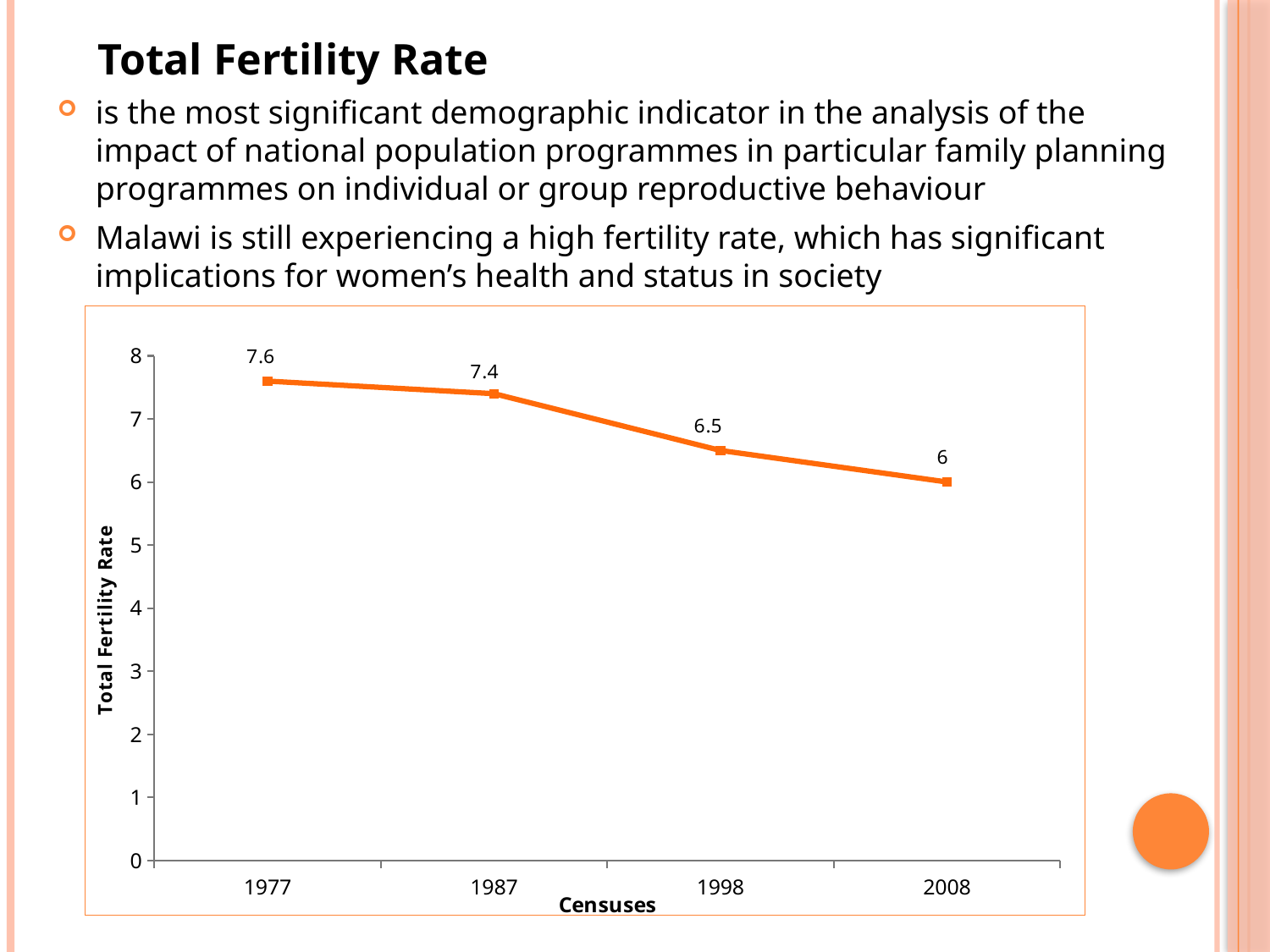
Does the total fertility rate rise or fall across the census years from 1977 to 2008? Fall Which census year has the lowest total fertility rate? 2008 What kind of chart is shown on the slide? Line chart What is the difference between the total fertility rate in 1987 and in 1998? 0.9 What is the total fertility rate for the 2008 census? 6 What is the total fertility rate for the 1987 census? 7.4 What is the total fertility rate for the 1998 census? 6.5 How many census years are plotted on the chart? 4 What is the difference between the total fertility rate in 1977 and in 2008? 1.6 What is the total fertility rate for the 1977 census? 7.6 Which is larger, the total fertility rate in 1987 or in 1998? 1987 Which census year has the highest total fertility rate? 1977